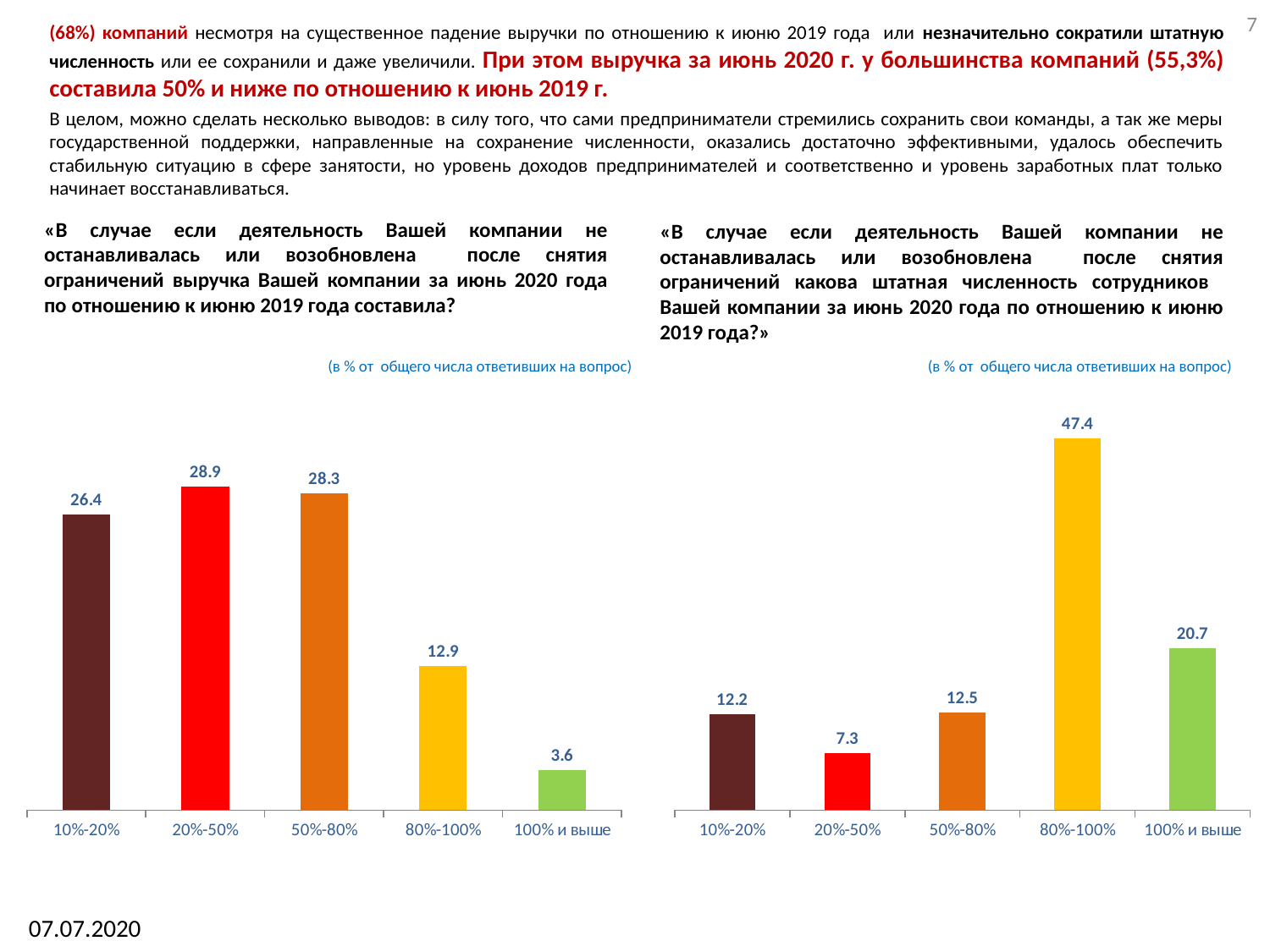
On the right chart (headcount for June 2020 vs June 2019), which category has the lowest value? 20%-50% On the left chart (revenue for June 2020 vs June 2019), which category has the lowest value? 100% и выше On the right chart (headcount for June 2020 vs June 2019), what is the value for the 80%-100% category? 47.4 On the left chart (revenue for June 2020 vs June 2019), which category has the highest value? 20%-50% On the left chart (revenue for June 2020 vs June 2019), what is the difference between the values for 50%-80% and 80%-100%? 15.4 On the right chart (headcount for June 2020 vs June 2019), what is the difference between the values for 80%-100% and 100% и выше? 26.7 How many categories are shown on the left chart (revenue for June 2020 vs June 2019)? 5 What type of chart is the right chart (headcount for June 2020 vs June 2019)? Bar chart On the right chart (headcount for June 2020 vs June 2019), which is larger: the value for 10%-20% or the value for 100% и выше? 100% и выше On the left chart (revenue for June 2020 vs June 2019), what is the value for the 10%-20% category? 26.4 On the right chart (headcount for June 2020 vs June 2019), what is the value for the 20%-50% category? 7.3 On the left chart (revenue for June 2020 vs June 2019), what is the value for the 80%-100% category? 12.9